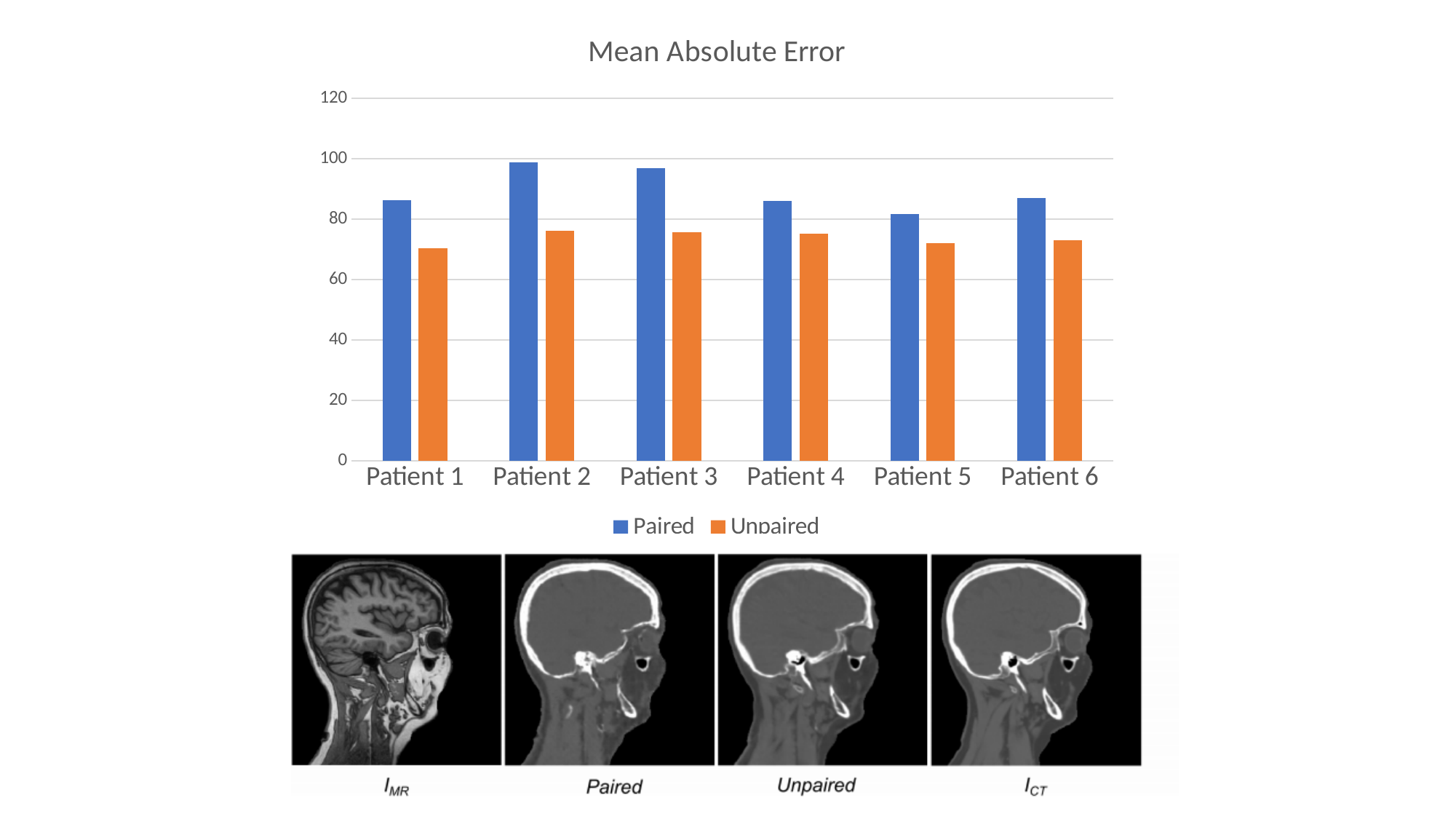
For Patient 3, which is larger, the Paired or the Unpaired value? Paired What kind of chart is shown on the slide? bar chart Is the Paired value for Patient 1 greater or less than 80? greater Which colour represents the Unpaired series? orange How many series does the legend list? 2 For Patient 6, which is larger, the Paired or the Unpaired value? Paired Which patient has the lowest Paired value? Patient 5 Is the Unpaired value for Patient 1 greater or less than 80? less What is the title of the chart? Mean Absolute Error Is the Unpaired value for Patient 5 greater or less than 60? greater How many patients are shown on the x axis? 6